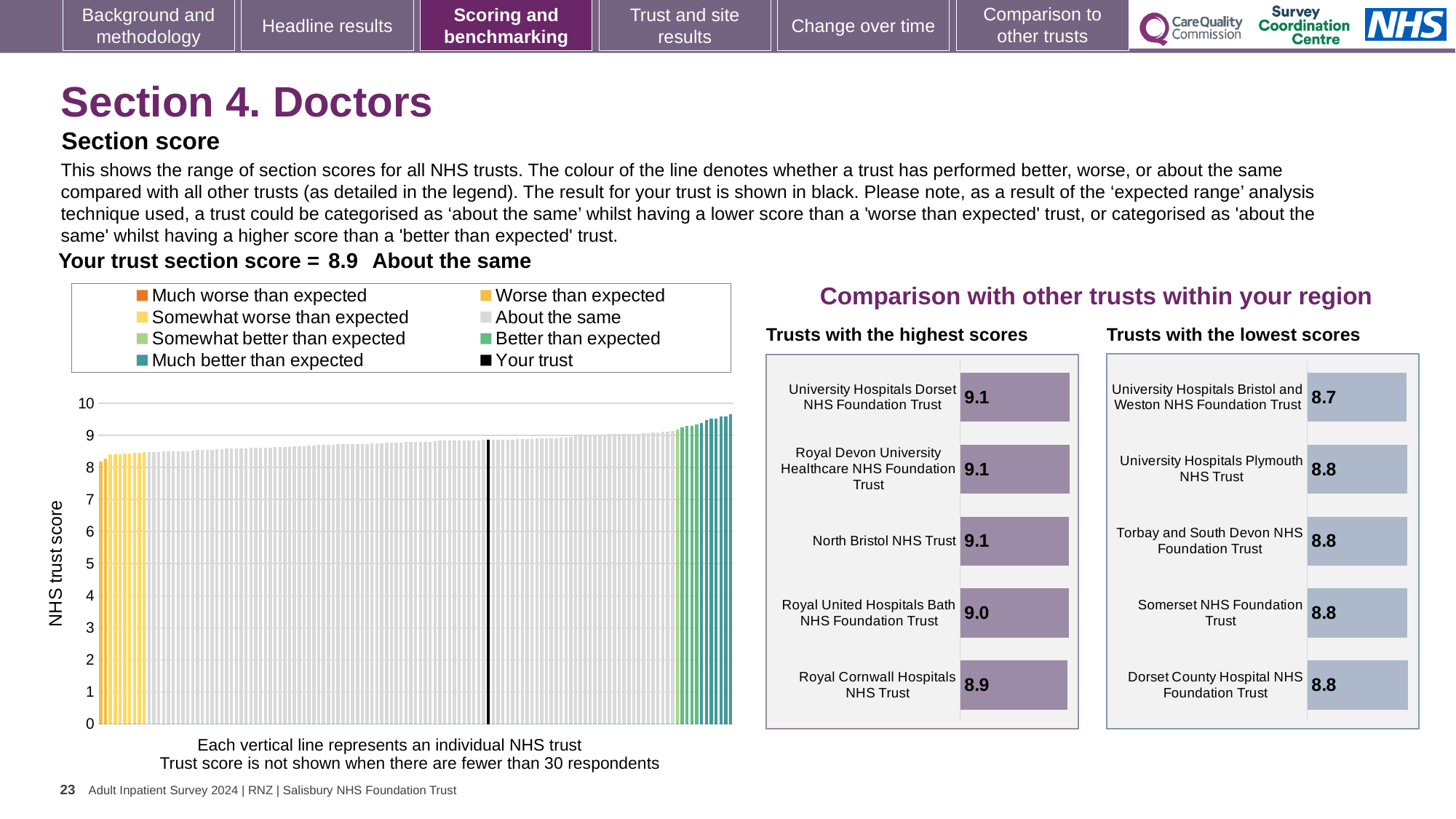
In the 'Trusts with the lowest scores' chart, which trust has the lowest score? University Hospitals Bristol and Weston NHS Foundation Trust In the large chart on the left, do the trust scores rise or fall from left to right along the x axis? rise What is the y-axis label of the large chart on the left? NHS trust score In the 'Trusts with the highest scores' chart, what is the difference between the scores of University Hospitals Dorset NHS Foundation Trust and Royal Cornwall Hospitals NHS Trust? 0.2 In the 'Trusts with the highest scores' chart, how many trusts are shown? 5 In the large chart on the left, is the value of the black bar (your trust) greater or less than 8? greater What is your trust's section score for Doctors, as stated on the slide? 8.9 In the 'Trusts with the lowest scores' chart, which is larger: the score for Torbay and South Devon NHS Foundation Trust or the score for University Hospitals Bristol and Weston NHS Foundation Trust? Torbay and South Devon NHS Foundation Trust In the 'Trusts with the highest scores' chart, what is the score for Royal United Hospitals Bath NHS Foundation Trust? 9.0 In the 'Trusts with the highest scores' chart, which trust has the lowest score? Royal Cornwall Hospitals NHS Trust In the large chart on the left, how many entries does the legend list? 8 What kind of chart is the large chart on the left showing NHS trust scores? bar chart